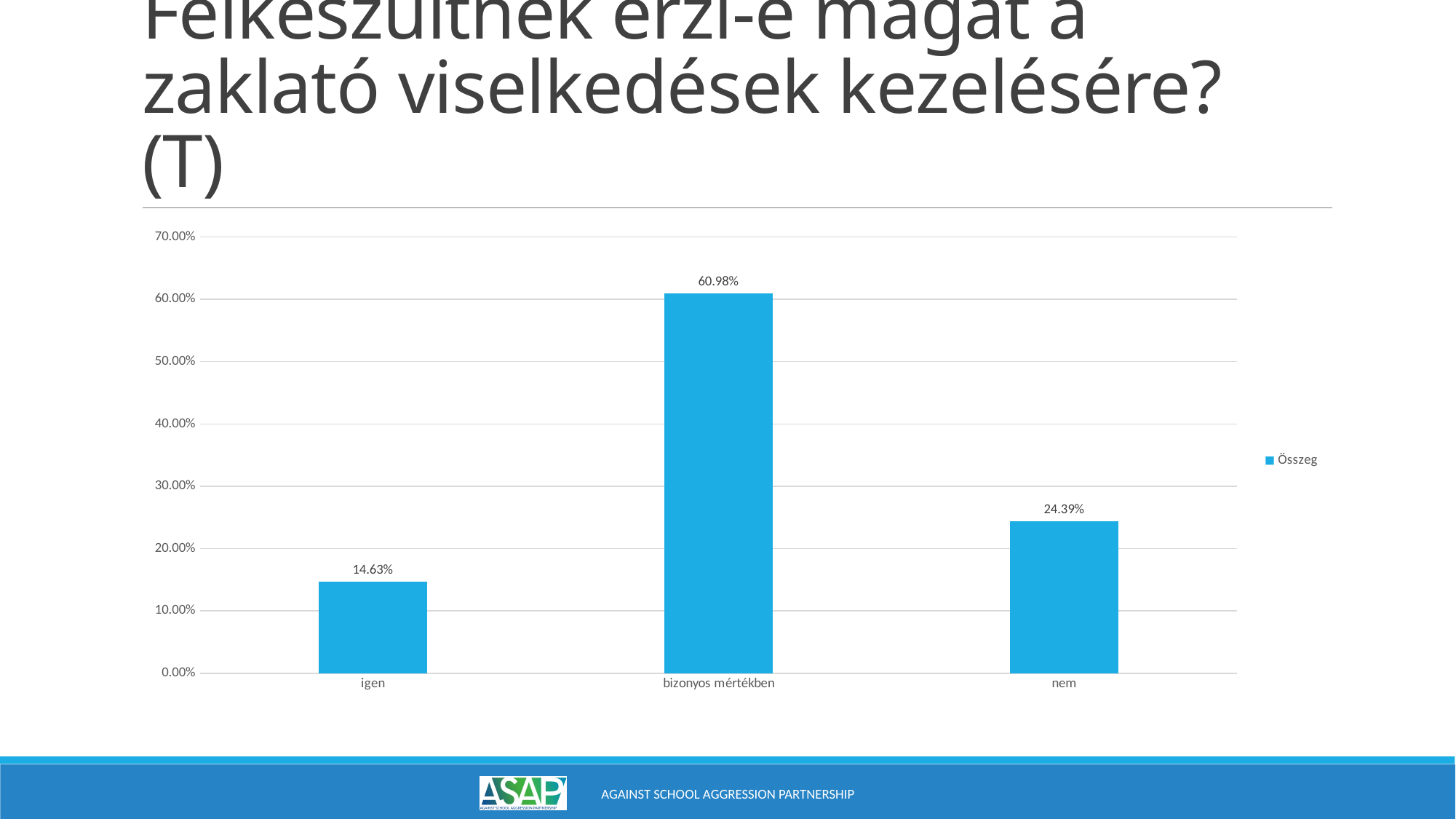
What is the value for "bizonyos mértékben"? 60.98% What is the value for "nem"? 24.39% What is the value for "igen"? 14.63% Which category has the lowest value? igen Which category has the highest value? bizonyos mértékben What is the difference between the values for "nem" and "igen"? 9.76% What is the difference between the values for "bizonyos mértékben" and "nem"? 36.59% Which is larger, the value for "nem" or the value for "igen"? nem Is the value for "bizonyos mértékben" greater or less than 50.00%? greater What kind of chart is shown on the slide? bar chart How many categories are shown on the x axis? 3 What series name does the legend show? Összeg